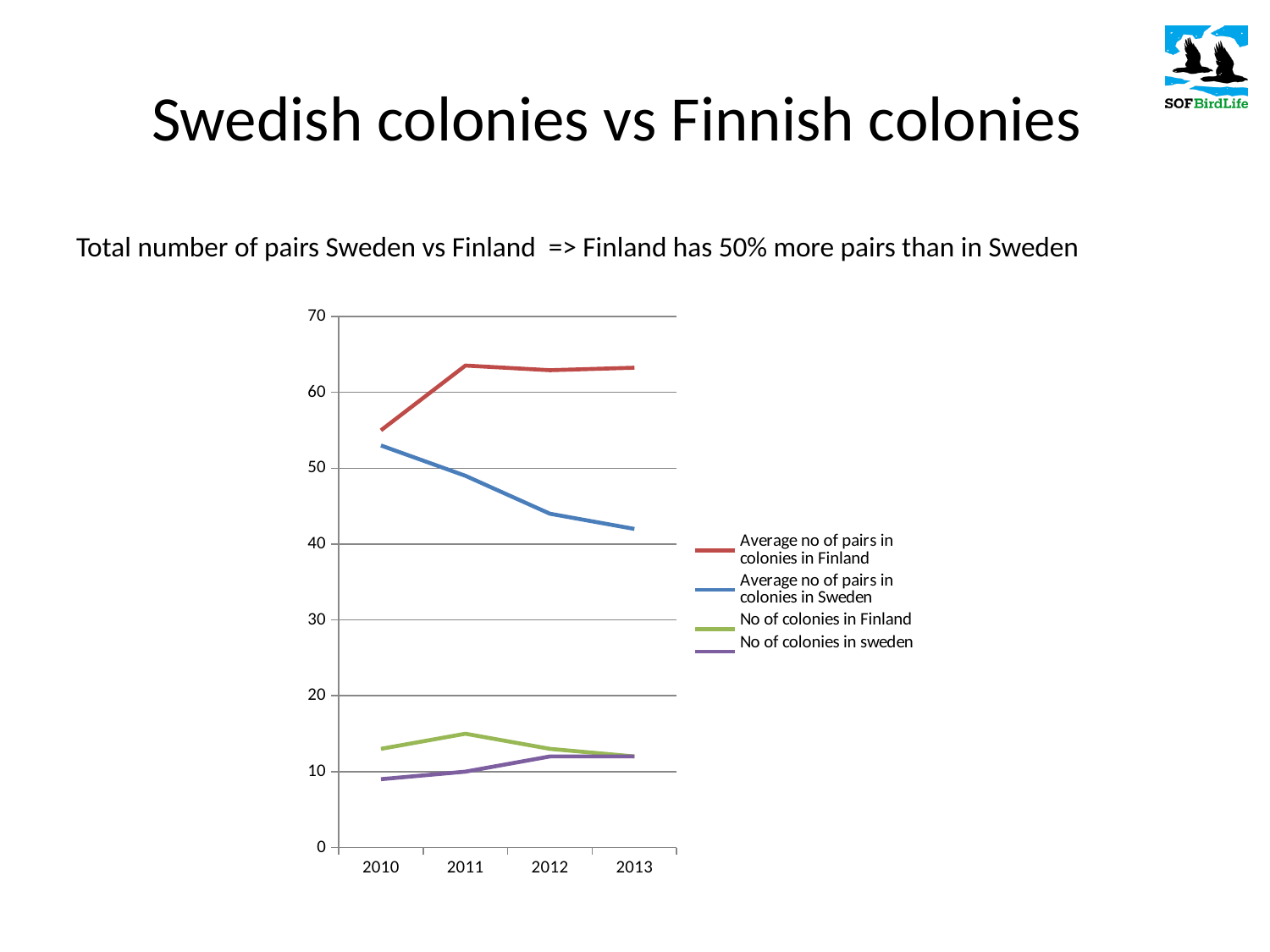
Does the Average no of pairs in colonies in Sweden rise or fall from 2010 to 2013? fall Is the value for Average no of pairs in colonies in Finland in 2011 greater or less than 60? greater Does the Average no of pairs in colonies in Finland rise or fall from 2010 to 2011? rise What is the title of the slide containing the chart? Swedish colonies vs Finnish colonies Is the value for Average no of pairs in colonies in Sweden in 2013 greater or less than 50? less Is the value for No of colonies in Finland in 2011 greater or less than 10? greater How many years are plotted along the x axis? 4 In 2013, which is larger: Average no of pairs in colonies in Finland or Average no of pairs in colonies in Sweden? Average no of pairs in colonies in Finland How many series does the legend list? 4 What kind of chart is shown on the slide? line chart